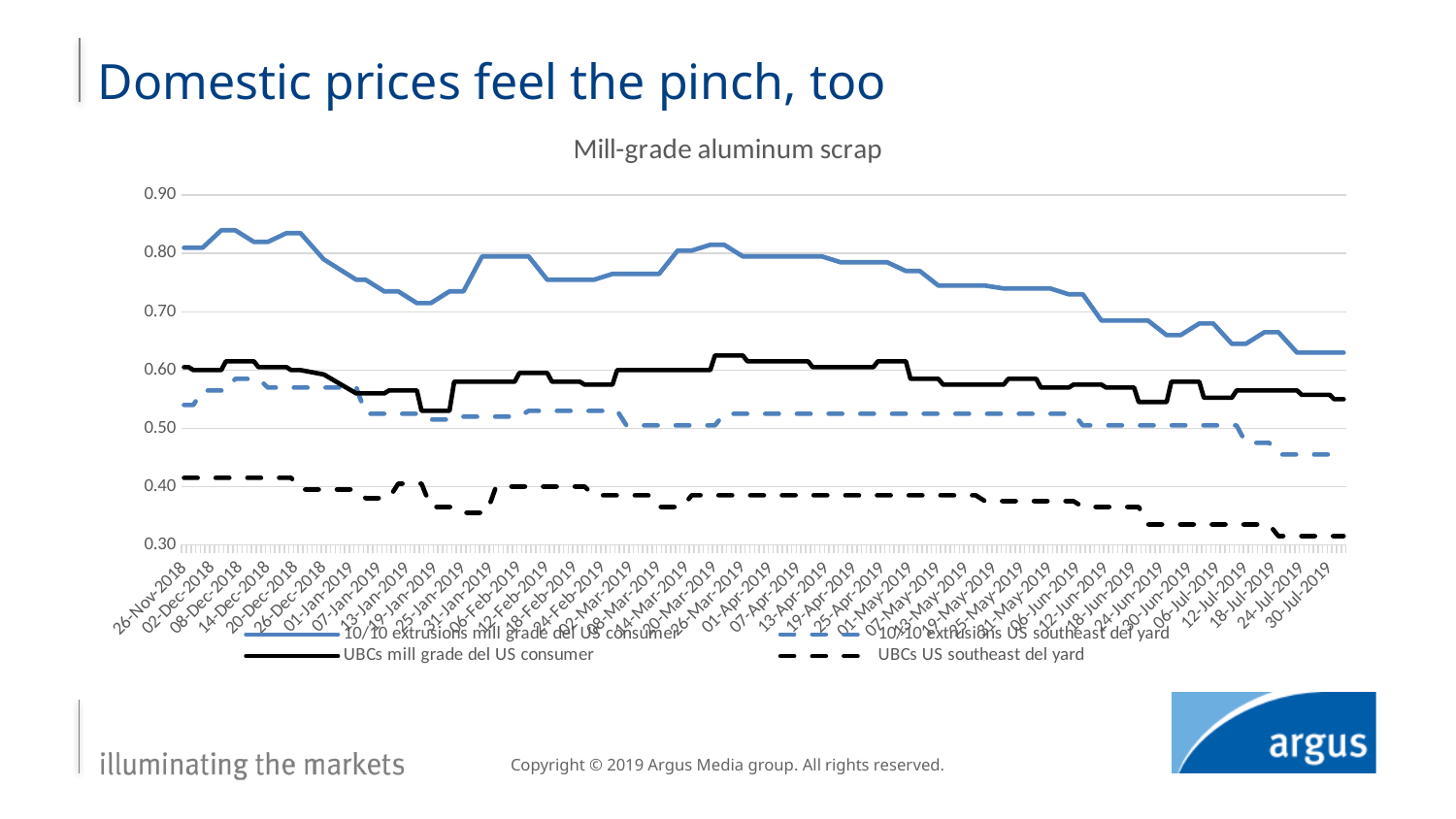
Is the value for 10/10 extrusions US southeast del yard at 30-Jul-2019 greater or less than 0.50? less Is the value for 10/10 extrusions mill grade del US consumer at 30-Jul-2019 greater or less than 0.70? less Is the value for UBCs mill grade del US consumer at 26-Nov-2018 greater or less than 0.50? greater Does the UBCs US southeast del yard series rise or fall overall from 26-Nov-2018 to 30-Jul-2019? fall How many series does the legend of the chart list? 4 What is the title of the chart? Mill-grade aluminum scrap Which series is drawn as a dashed blue line? 10/10 extrusions US southeast del yard Does the 10/10 extrusions mill grade del US consumer series rise or fall overall from 26-Nov-2018 to 30-Jul-2019? fall What kind of chart is shown on the slide? line chart Which series has the highest values across the whole period shown? 10/10 extrusions mill grade del US consumer